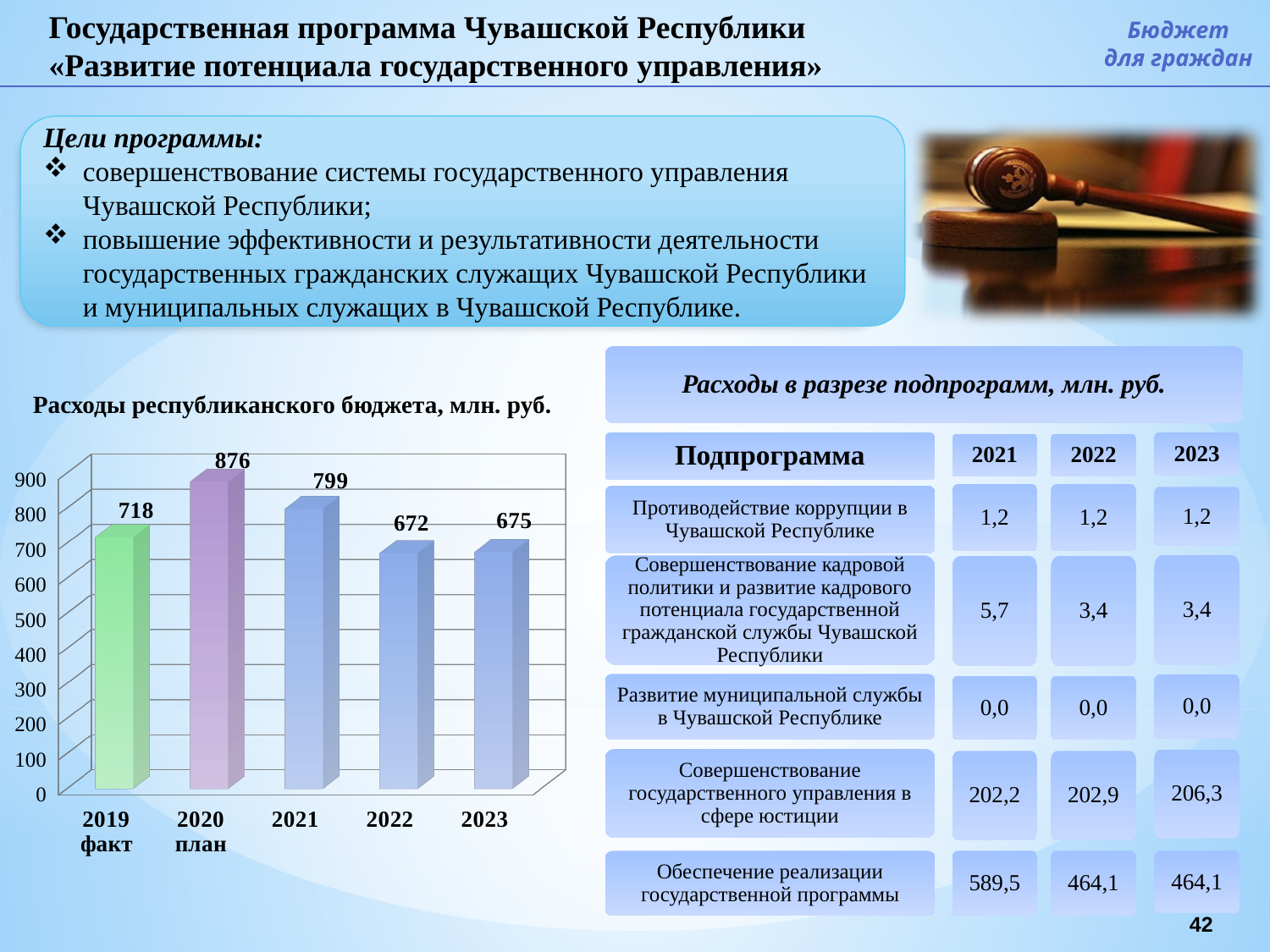
What is the value for 2019 факт in the chart? 718 What is the value for 2023 in the chart? 675 Which category has the lowest value in the chart? 2022 What is the title of the chart on the slide? Расходы республиканского бюджета, млн. руб. Is the value for 2020 план in the chart greater or less than 800? greater What is the difference between the values for 2019 факт and 2022 in the chart? 46 What is the value for 2021 in the chart "Расходы республиканского бюджета, млн. руб."? 799 What is the difference between the values for 2020 план and 2021 in the chart? 77 What kind of chart is shown on the slide? bar chart Which is larger in the chart: the value for 2019 факт or the value for 2021? 2021 How many categories are shown on the x axis of the chart? 5 Which category has the highest value in the chart? 2020 план